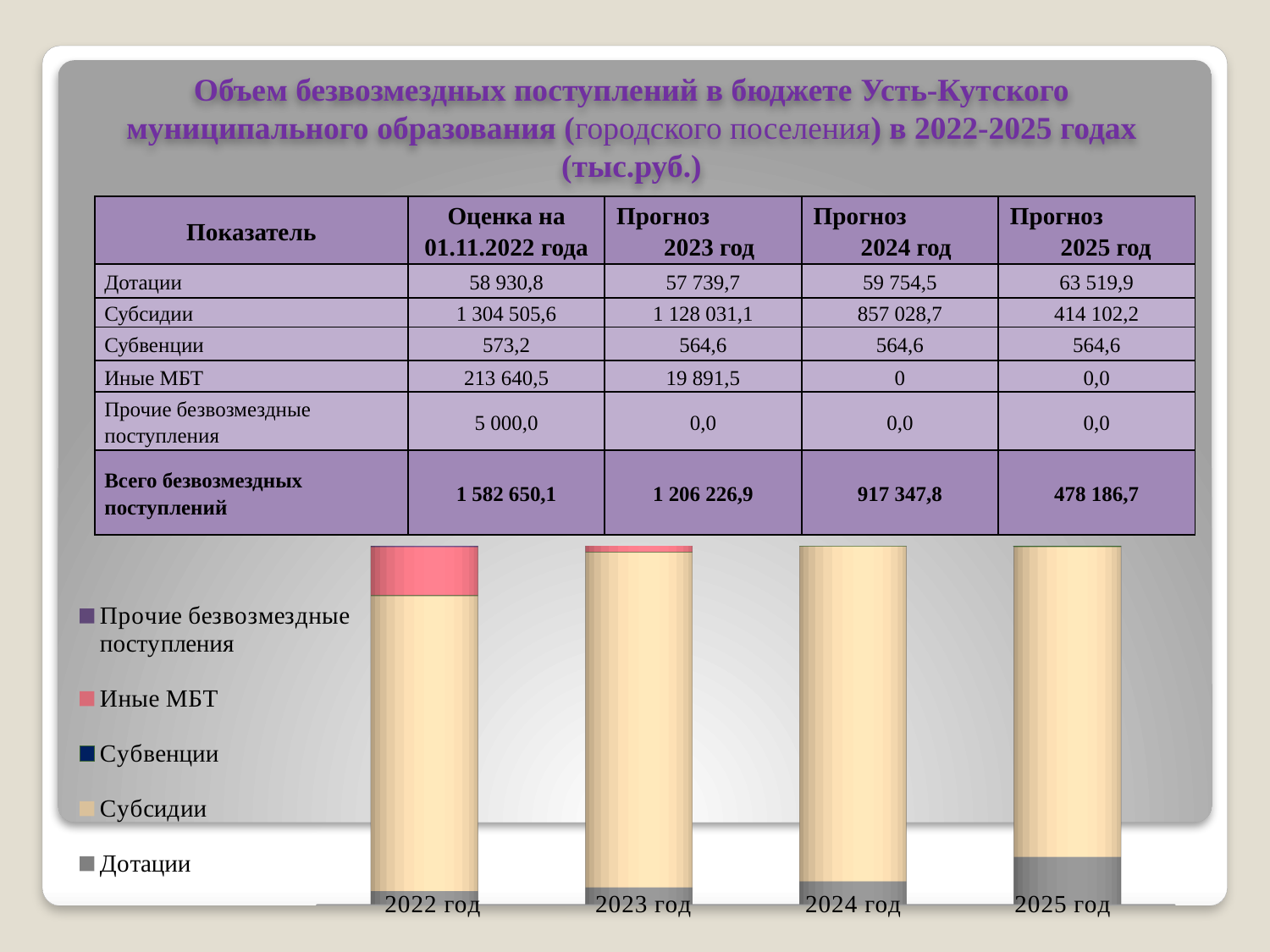
In which year is the Дотации segment of the bar the largest? 2025 год Which series are listed in the chart legend? Прочие безвозмездные поступления, Иные МБТ, Субвенции, Субсидии, Дотации Is the Дотации segment larger in the 2022 год bar or the 2025 год bar? 2025 год In which year is the Иные МБТ segment of the bar the largest? 2022 год Which series forms the bottom segment of each bar in the chart? Дотации What kind of chart is shown at the bottom of the slide? Stacked bar chart Does the share of Дотации in the bars rise or fall from 2022 год to 2025 год? Rises Does the share of Субсидии in the bars rise or fall from 2022 год to 2025 год? Rises Which year's bar has the smallest Дотации segment? 2022 год How many series does the chart legend list? 5 How many bars (years) are plotted in the chart? 4 Is the Иные МБТ segment larger in the 2022 год bar or the 2023 год bar? 2022 год